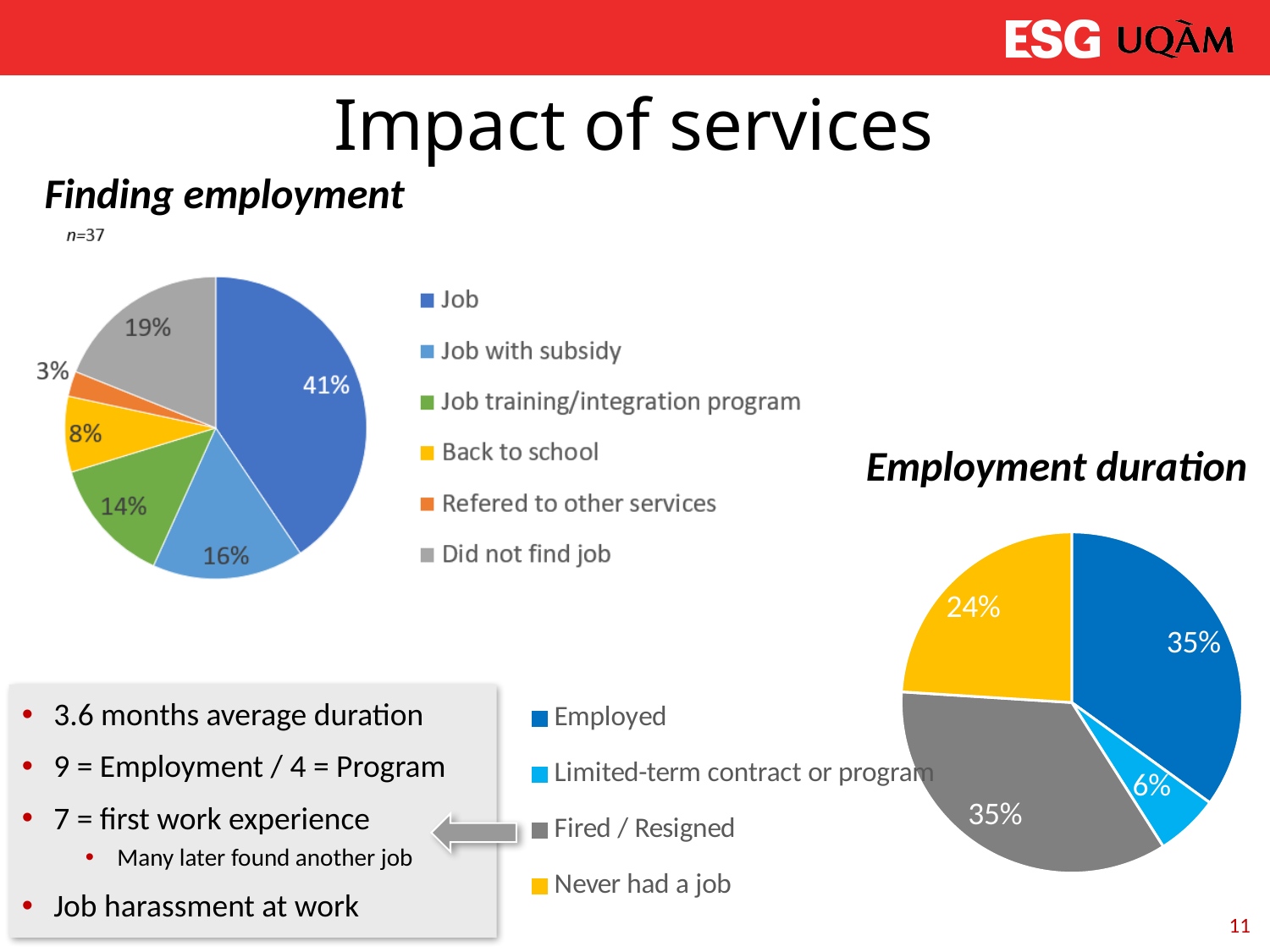
In the Finding employment pie chart, which category has the smallest share? Refered to other services In the Employment duration pie chart, which is larger: Employed or Never had a job? Employed In the Finding employment pie chart, what share went back to school? 8% In the Finding employment pie chart, what share of respondents found a job? 41% What type of chart is used for Employment duration? Pie chart In the Employment duration pie chart, what share is Never had a job? 24% What sample size is shown for the Finding employment pie chart? n=37 In the Finding employment pie chart, what percentage did not find a job? 19% In the Finding employment pie chart, what is the difference between the share for Job with subsidy and the share for Job training/integration program? 2% In the Finding employment pie chart, which category has the largest share? Job How many categories does the Finding employment pie chart show? 6 In the Employment duration pie chart, which category has the smallest share? Limited-term contract or program